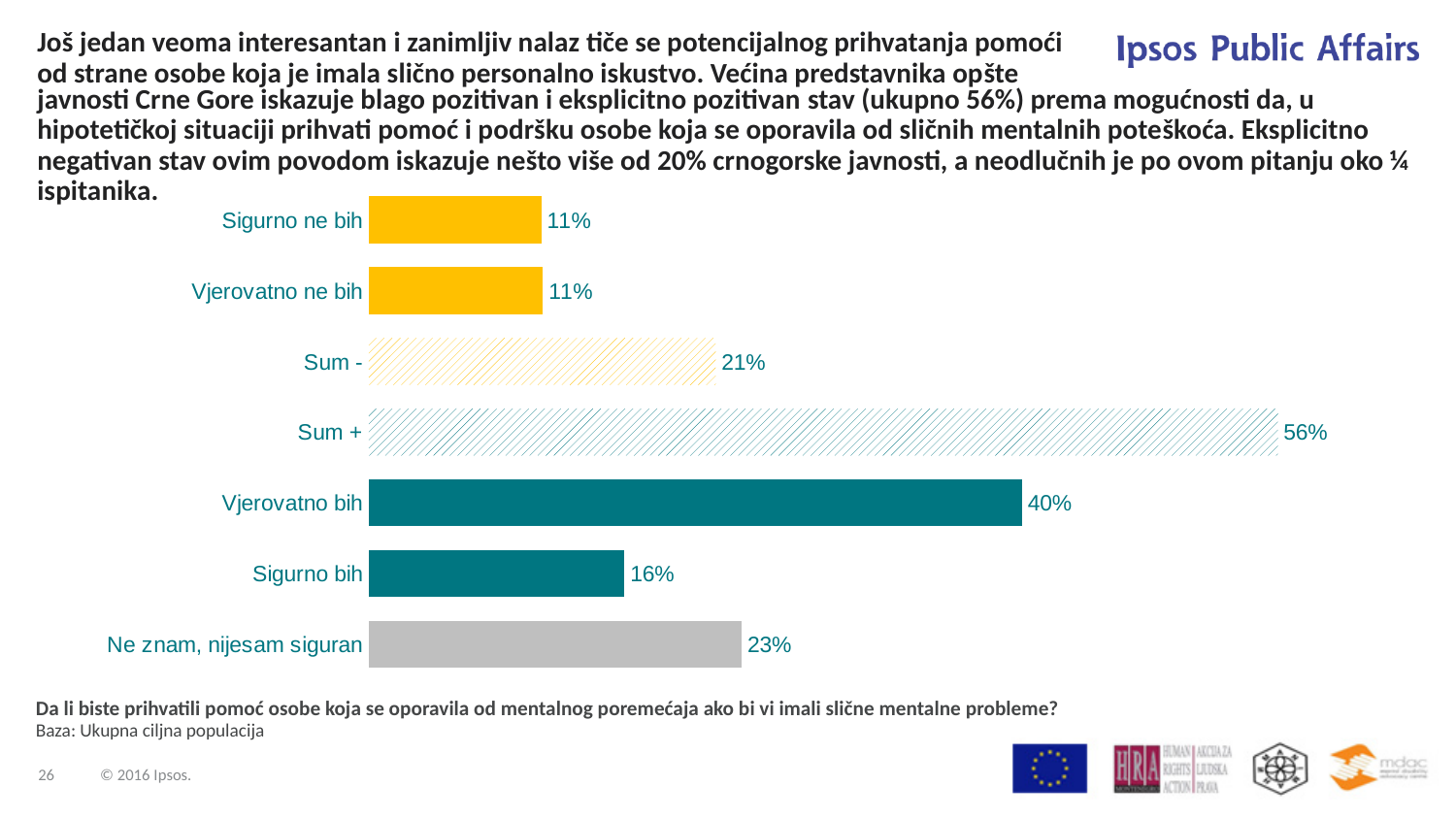
What is the difference between "Sum +" and "Sum -"? 35% What is the value for "Sigurno bih"? 16% What kind of chart is shown on the slide? Bar chart What is the value for "Sigurno ne bih"? 11% Which is larger, "Ne znam, nijesam siguran" or "Sum -"? Ne znam, nijesam siguran Which categories are shown with hatched (striped) bars? Sum - and Sum + Which category has the highest value? Sum + How many categories are shown in the chart? 7 What is the value for "Sum +"? 56% What is the difference between "Vjerovatno bih" and "Sigurno bih"? 24% What is the value for "Ne znam, nijesam siguran"? 23% What is the value for "Vjerovatno bih"? 40%